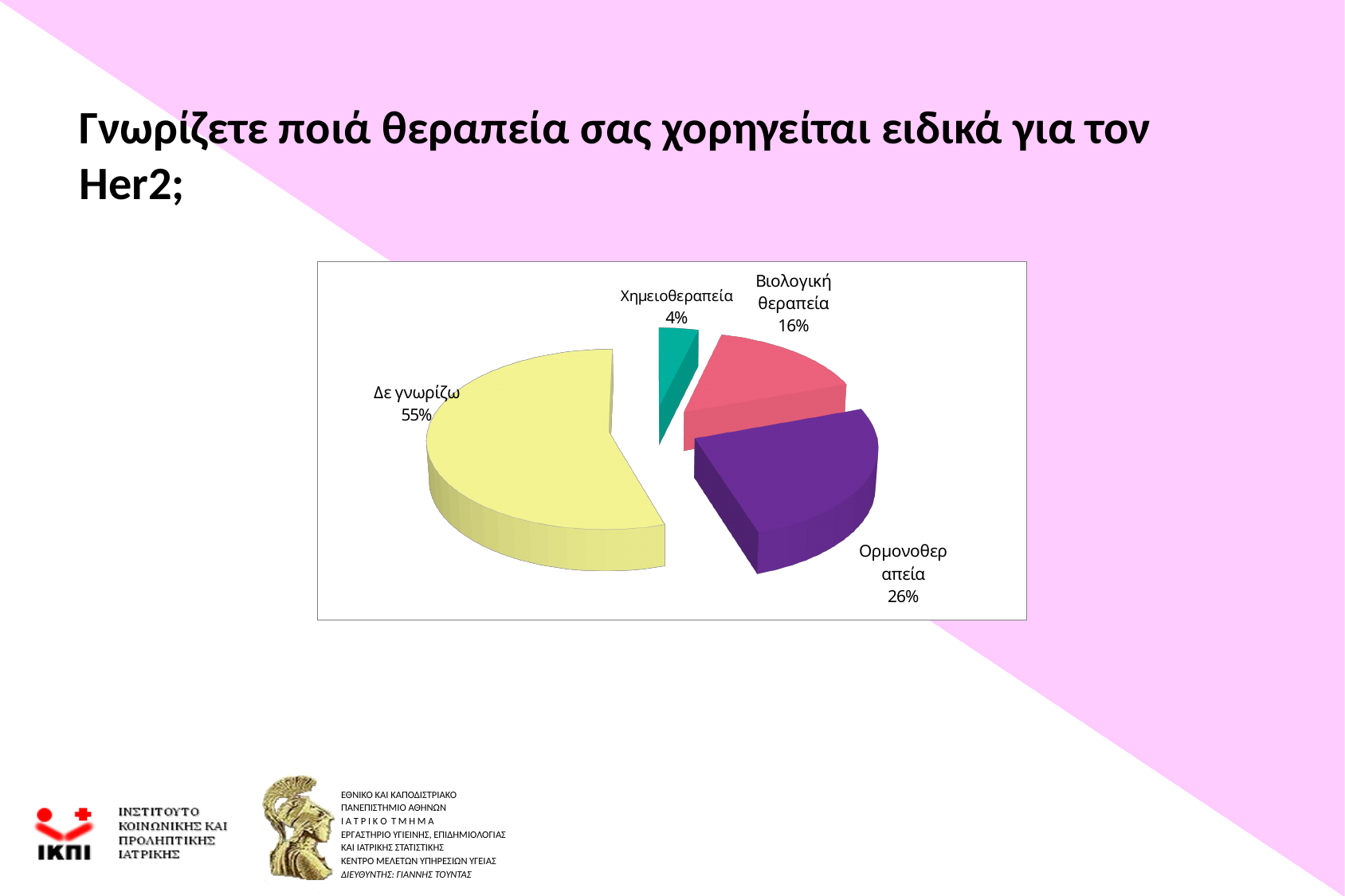
Which is larger, the share for "Βιολογική θεραπεία" or the share for "Χημειοθεραπεία"? Βιολογική θεραπεία What colour is the "Δε γνωρίζω" slice? Yellow Which category has the smallest slice of the pie? Χημειοθεραπεία What is the value shown for "Ορμονοθεραπεία"? 26% What is the difference between the shares of "Ορμονοθεραπεία" and "Βιολογική θεραπεία"? 10% What share of the pie does "Δε γνωρίζω" represent? 55% Which category has the largest slice of the pie? Δε γνωρίζω What is the value shown for "Βιολογική θεραπεία"? 16% What is the value shown for "Χημειοθεραπεία"? 4% What is the difference between the shares of "Δε γνωρίζω" and "Ορμονοθεραπεία"? 29% How many slices does the pie chart have? 4 What kind of chart is shown on the slide? Pie chart